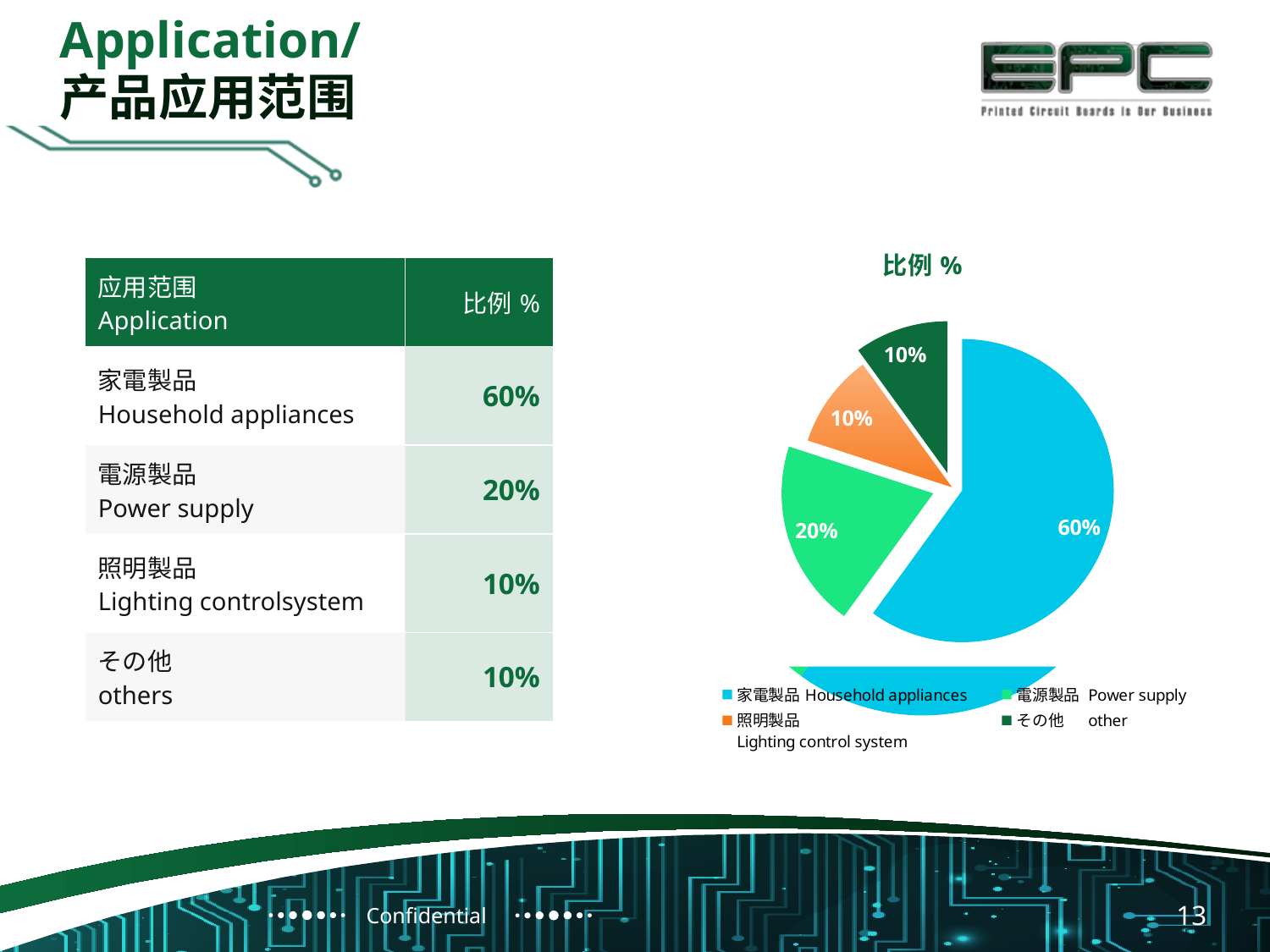
What is the difference between the Household appliances share and the Power supply share? 40% What kind of chart is shown on the slide? pie chart How many slices does the pie chart have? 4 How many entries does the legend list? 4 Which category has the largest slice of the pie? Household appliances (家電製品) What is the combined share of Lighting control system and other (その他)? 20% What is the chart's title? 比例 % What share of the pie does Lighting control system (照明製品) have? 10% Which is larger, the Power supply slice or the other (その他) slice? Power supply What colour is the Household appliances slice? light blue What share of the pie does Household appliances (家電製品) have? 60% What share of the pie does Power supply (電源製品) have? 20%